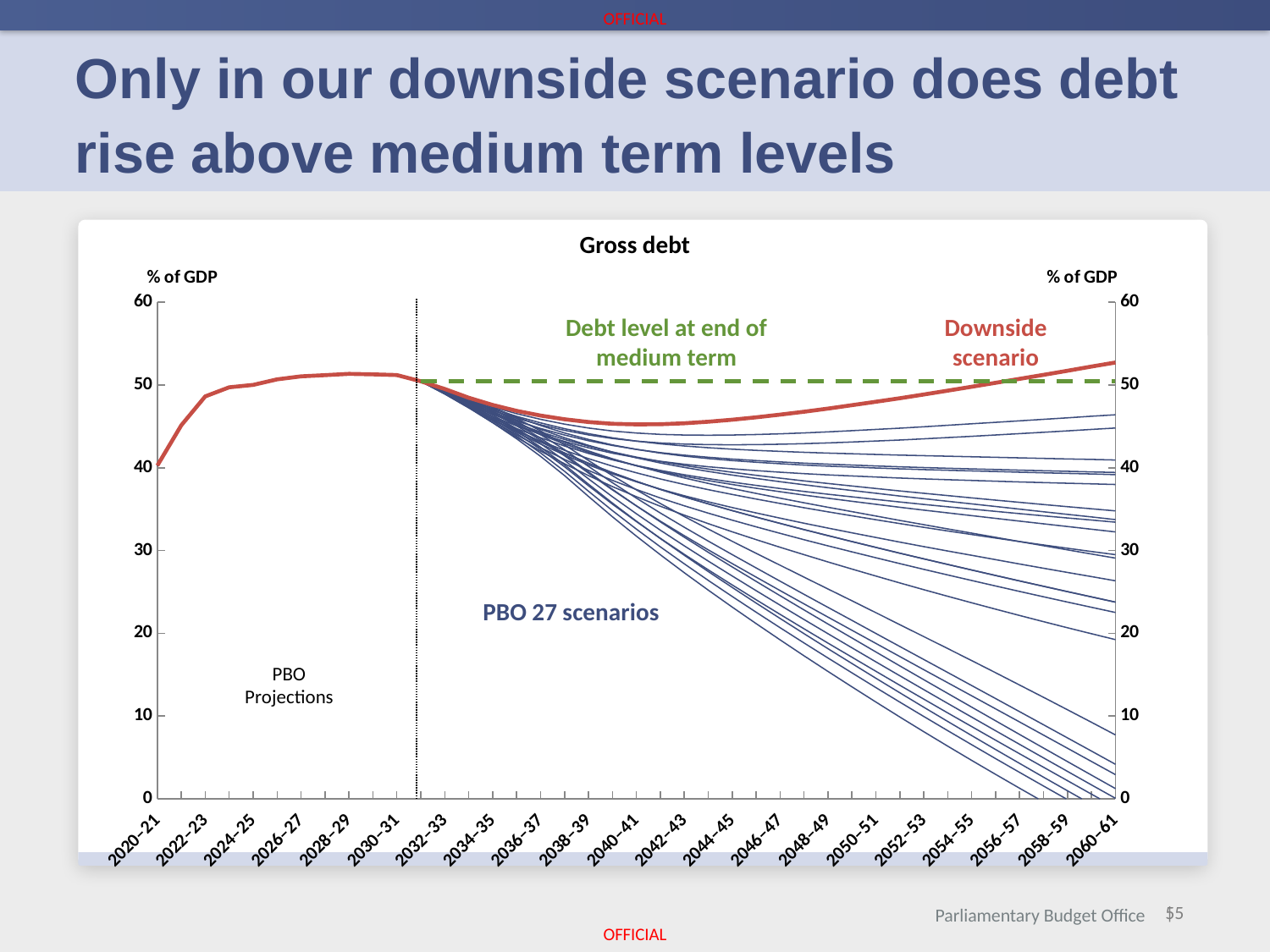
Which is larger in 2060-61: the Downside scenario or the Debt level at end of medium term? Downside scenario What is the highest value shown on the y axis? 60 Is the value of the Downside scenario in 2040-41 greater or less than 50? less Does the Downside scenario line rise or fall between 2042-43 and 2060-61? rise What kind of chart is shown on the slide? line chart Is the highest of the PBO 27 scenarios in 2060-61 greater or less than 50? less How many scenarios do the blue lines represent, according to the label on the chart? 27 Is the value of the Downside scenario in 2060-61 greater or less than 50? greater What unit is shown on the y axis of the chart? % of GDP Does the Downside scenario line rise or fall between 2032-33 and 2040-41? fall What is the title of the chart? Gross debt